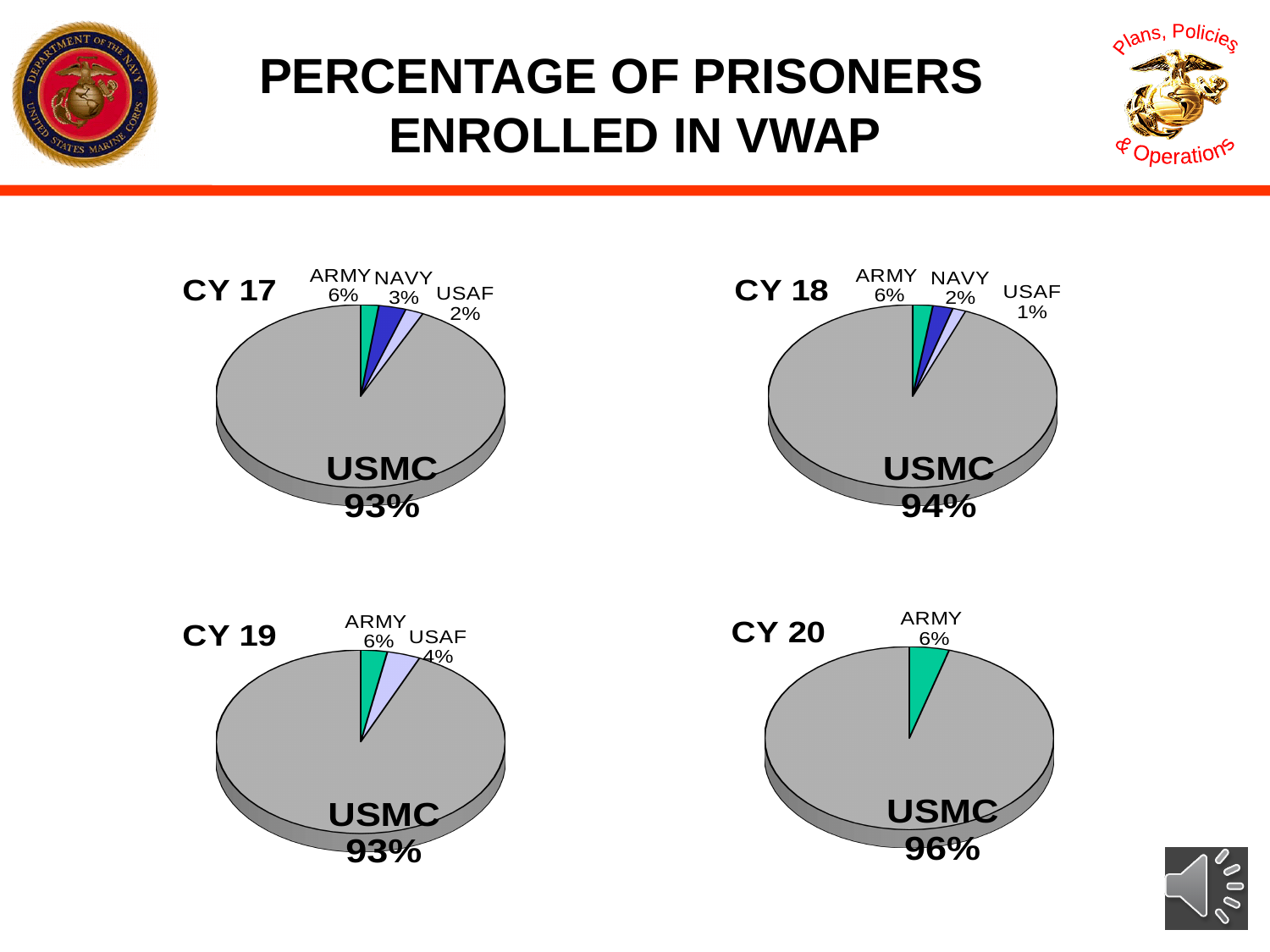
In the CY 17 pie chart, what is the difference between the NAVY and USAF percentages? 1% In the CY 19 pie chart, what percentage is shown for USAF? 4% How many slices does the CY 20 pie chart have? 2 How many slices does the CY 19 pie chart have? 3 In the CY 17 pie chart, which category has the largest share? USMC In the CY 18 pie chart, which category has the smallest share? USAF What kind of chart is used for CY 18? Pie chart In the CY 20 pie chart, what percentage is shown for USMC? 96% How many pie charts are shown on the slide? 4 In the CY 18 pie chart, what percentage is shown for USAF? 1% In the CY 17 pie chart, which is larger, the ARMY share or the NAVY share? ARMY In the CY 17 pie chart, what percentage is shown for USMC? 93%